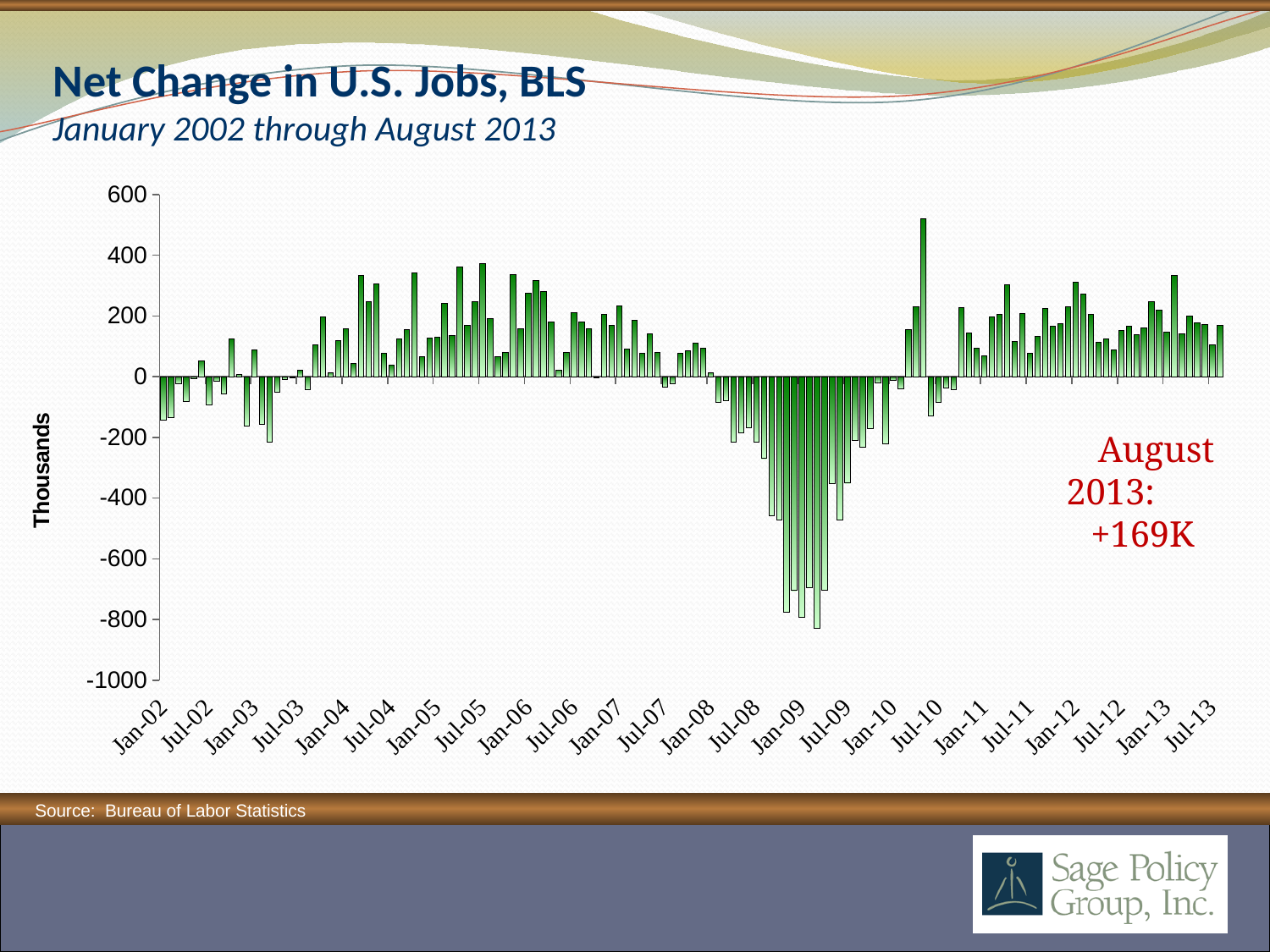
Is the tallest bar on the chart (in 2010) greater or less than 400? greater Do the values rise or fall from Jan-08 to Jan-09? fall Is the lowest bar on the chart (in early 2009) greater or less than -600? less Are the bars around Jan-09 positive or negative? negative What is the title of the chart? Net Change in U.S. Jobs, BLS What is the net change in U.S. jobs for August 2013 as printed on the slide? +169K How many labels are shown on the x axis? 24 What unit label is shown on the vertical axis? Thousands Is the value for August 2013 greater or less than 200? less In which year does the tallest bar appear? 2010 What kind of chart is shown on the slide? bar chart In which year do the bars reach their lowest point? 2009